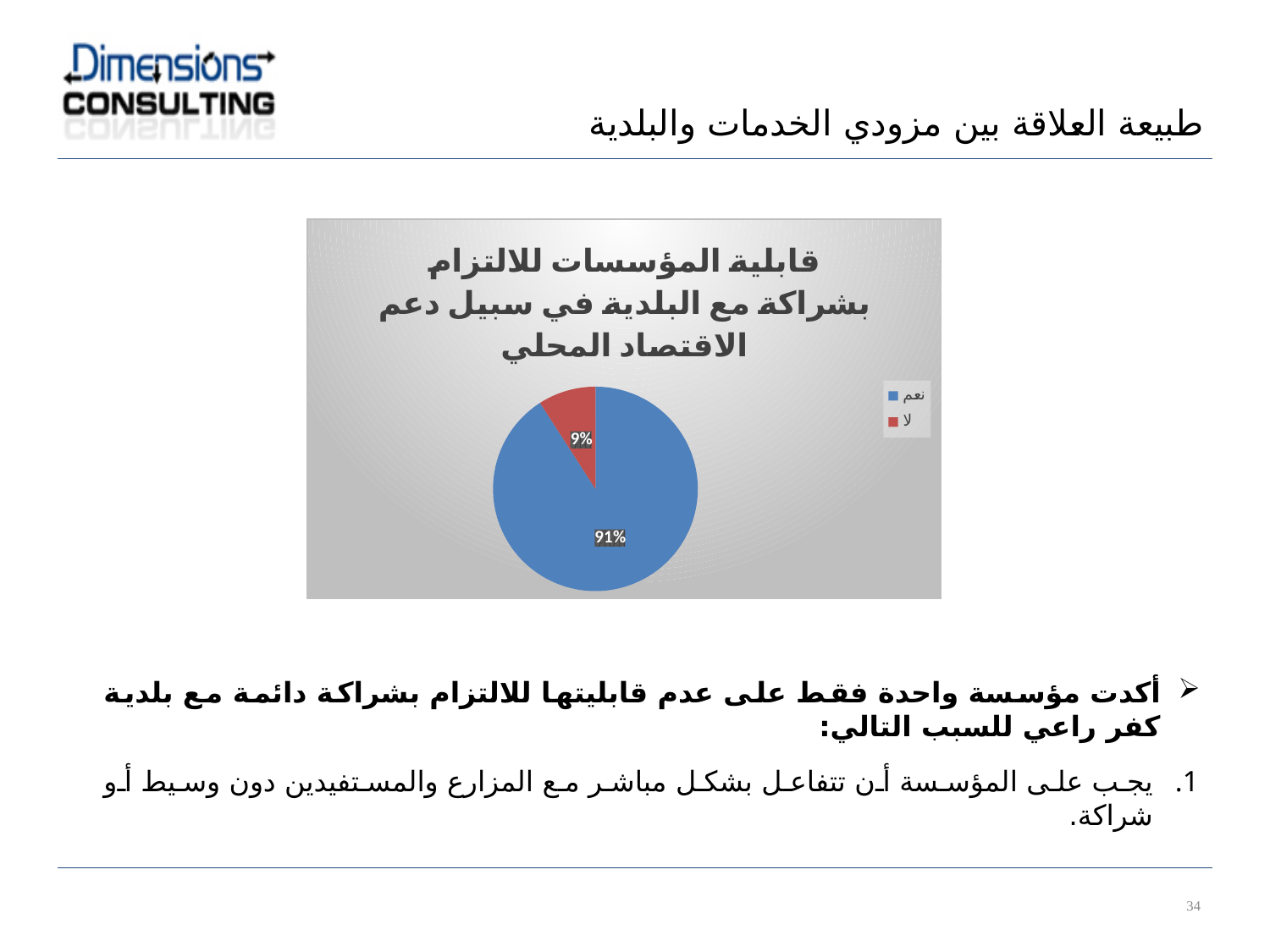
What is the title of the pie chart? قابلية المؤسسات للالتزام بشراكة مع البلدية في سبيل دعم الاقتصاد المحلي Which category has the largest slice of the pie? نعم Which category has the smallest slice of the pie? لا What kind of chart is shown on the slide? pie chart What share of the pie does the "نعم" slice represent? 91% What is the difference in percentage points between the "نعم" and "لا" slices? 82 How many entries does the legend list? 2 How many slices does the pie chart have? 2 Which slice is larger, "نعم" or "لا"? نعم What colour is the "لا" slice in the pie chart? red What share of the pie does the "لا" slice represent? 9%